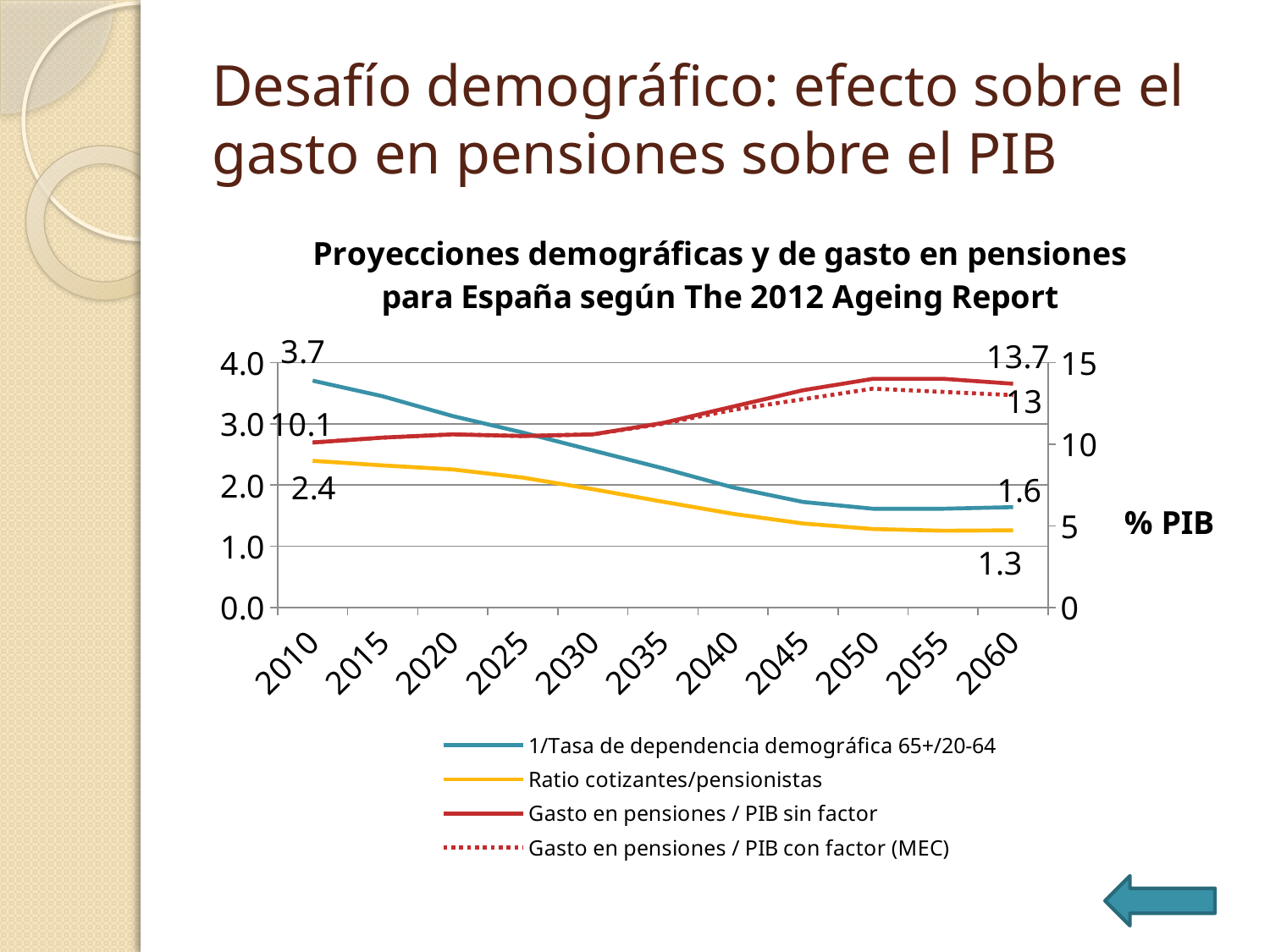
What is the value of '1/Tasa de dependencia demográfica 65+/20-64' in 2060? 1.6 What is the value of 'Ratio cotizantes/pensionistas' in 2010? 2.4 What is the value of 'Gasto en pensiones / PIB con factor (MEC)' in 2060? 13 What is the value of 'Gasto en pensiones / PIB sin factor' in 2060? 13.7 What type of chart is shown on the slide? line chart What is the value of '1/Tasa de dependencia demográfica 65+/20-64' in 2010? 3.7 How many years are shown on the x axis? 11 Does 'Ratio cotizantes/pensionistas' rise or fall from 2010 to 2060? fall How many series does the legend list? 4 What is the value of 'Ratio cotizantes/pensionistas' in 2060? 1.3 By how much does 'Gasto en pensiones / PIB sin factor' change between 2010 and 2060? 3.6 What is the value of 'Gasto en pensiones / PIB sin factor' in 2010? 10.1